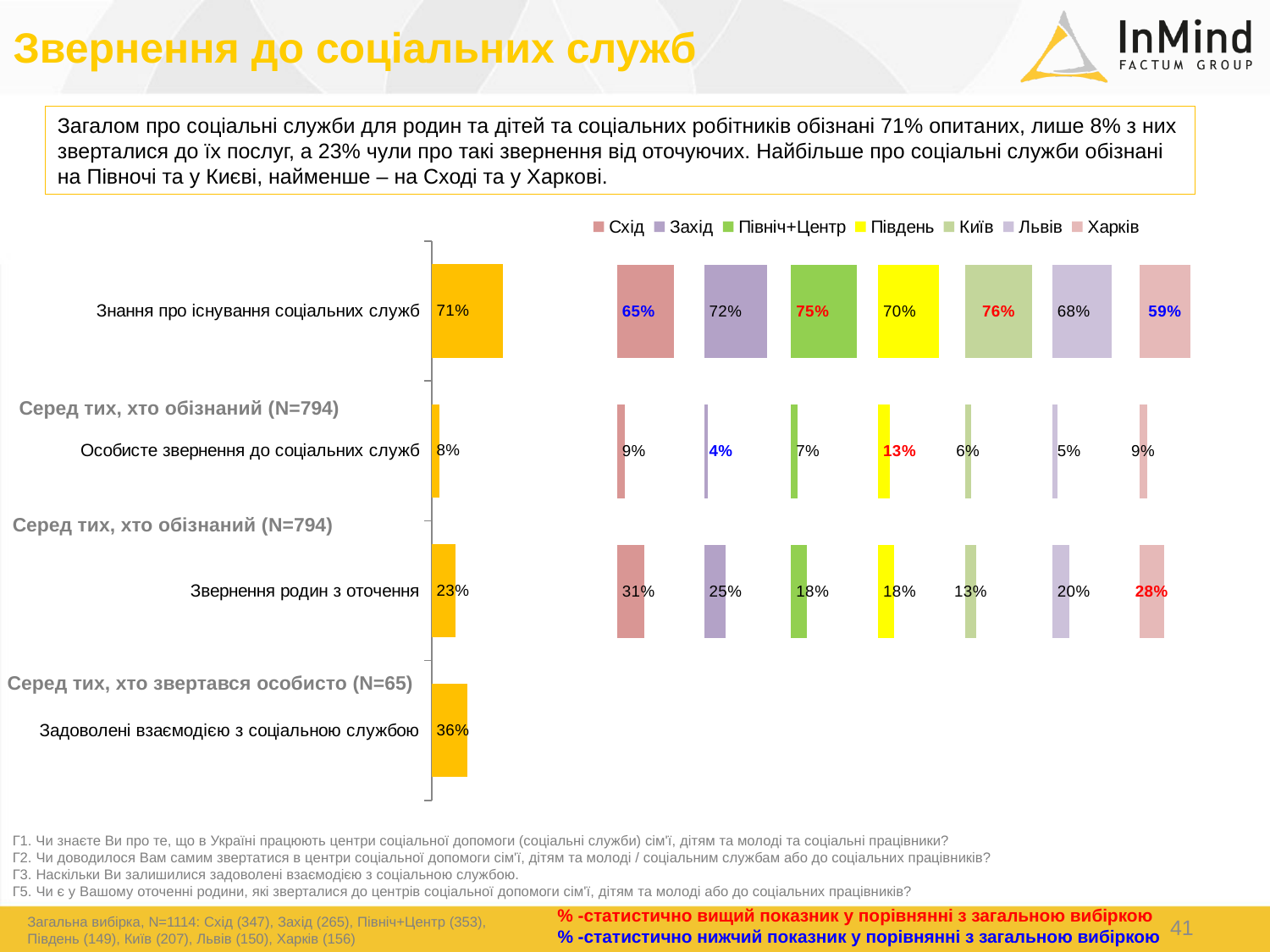
Which is larger for "Звернення родин з оточення": the value for Схід or the value for Київ? Схід What is the difference between the overall values for "Звернення родин з оточення" and "Особисте звернення до соціальних служб"? 15% Which region has the highest value for "Особисте звернення до соціальних служб"? Південь How many regions does the legend list? 7 Which region has the lowest value for "Знання про існування соціальних служб"? Харків What is the overall value for "Задоволені взаємодією з соціальною службою"? 36% Which region has the highest value for "Звернення родин з оточення"? Схід What is the value for Захід for "Особисте звернення до соціальних служб"? 4% What kind of chart is shown on the slide? Bar chart What is the value for Київ for "Знання про існування соціальних служб"? 76% What is the overall value for "Знання про існування соціальних служб" (the orange bar)? 71% What is the difference between the Київ and Харків values for "Знання про існування соціальних служб"? 17%